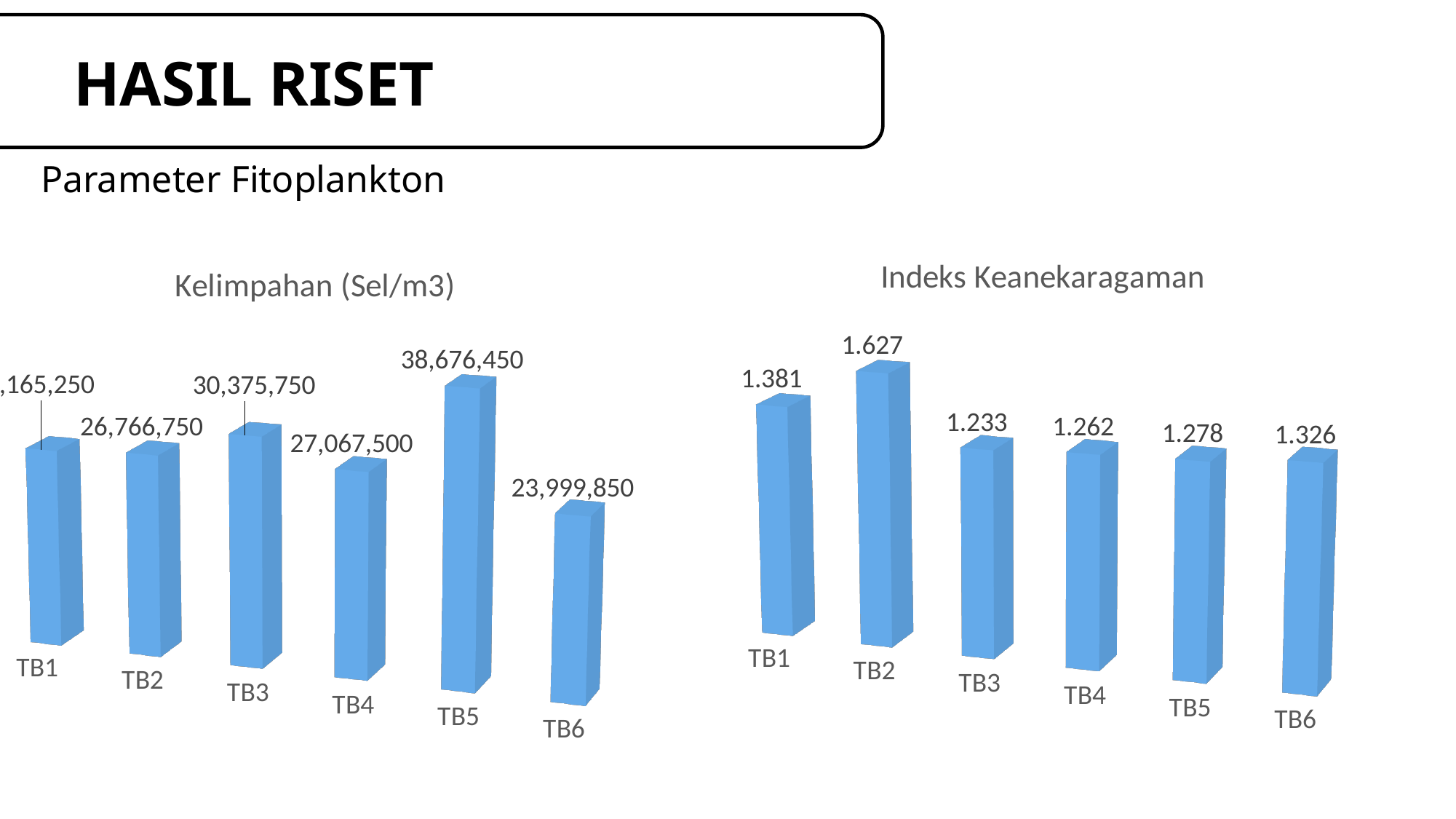
What type of chart is the Kelimpahan (Sel/m3) chart? Bar chart In the Kelimpahan (Sel/m3) chart, which station has the lowest value? TB6 In the Kelimpahan (Sel/m3) chart, which station has the highest value? TB5 In the Kelimpahan (Sel/m3) chart, what is the value for TB5? 38,676,450 In the Kelimpahan (Sel/m3) chart, what is the difference between TB5 and TB3? 8,300,700 In the Indeks Keanekaragaman chart, which station has the lowest value? TB3 In the Kelimpahan (Sel/m3) chart, which is larger, TB3 or TB4? TB3 In the Indeks Keanekaragaman chart, what is the value for TB2? 1.627 In the Kelimpahan (Sel/m3) chart, what is the value for TB2? 26,766,750 In the Indeks Keanekaragaman chart, what is the value for TB6? 1.326 In the Indeks Keanekaragaman chart, what is the difference between TB2 and TB1? 0.246 How many stations are shown in the Indeks Keanekaragaman chart? 6